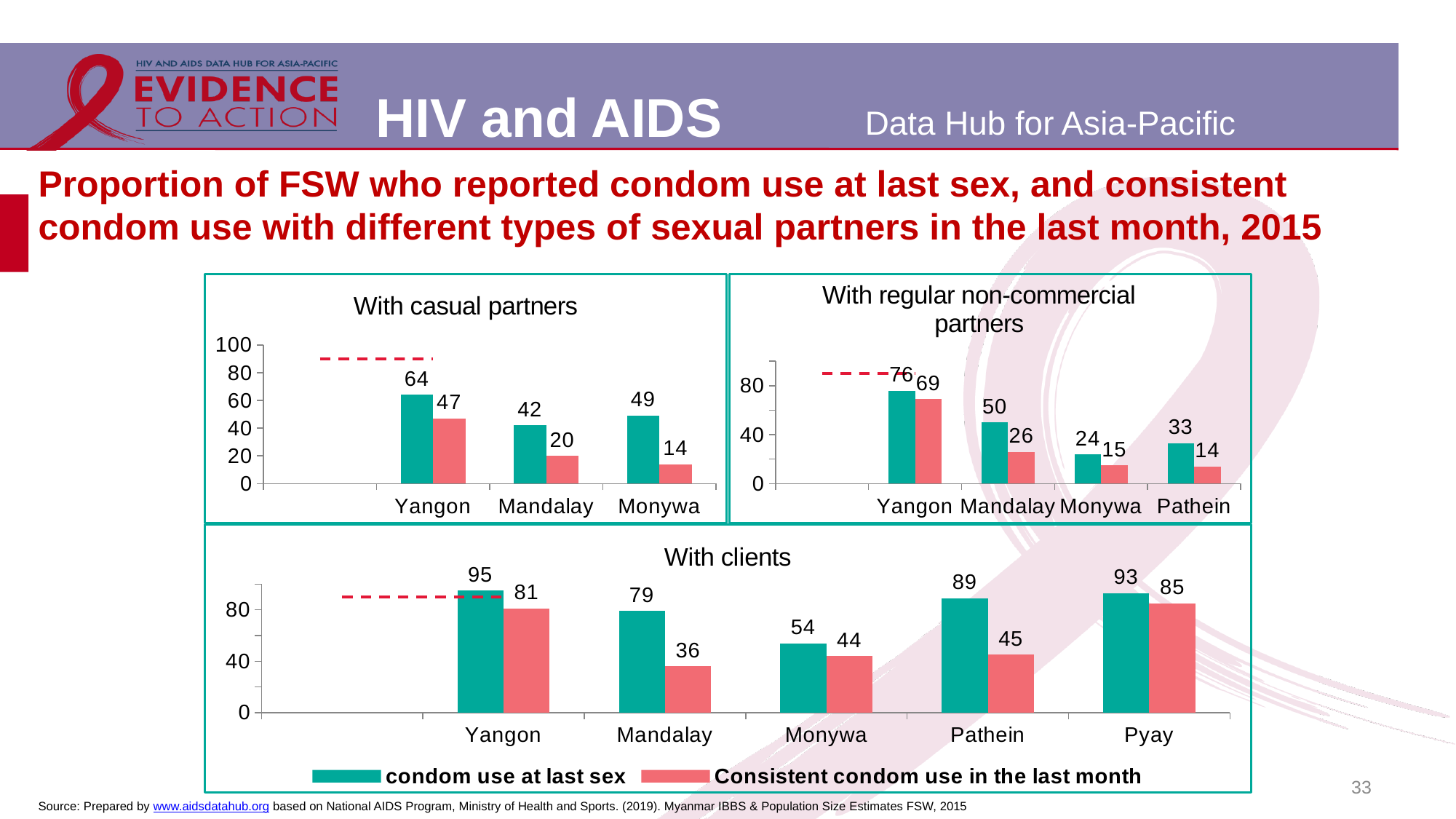
What type of chart is the 'With clients' chart? Bar chart In the 'With regular non-commercial partners' chart, what is the value for consistent condom use in the last month in Pathein? 14 In the 'With clients' chart, what is the difference between condom use at last sex and consistent condom use in the last month in Mandalay? 43 In the 'With clients' chart, what is the value for condom use at last sex in Pathein? 89 How many cities are shown in the 'With clients' chart? 5 In the 'With regular non-commercial partners' chart, which is larger: condom use at last sex in Monywa or in Pathein? Pathein In the 'With casual partners' chart, which city has the lowest value for consistent condom use in the last month? Monywa How many series does the legend list? 2 In the 'With casual partners' chart, what is the value for condom use at last sex in Yangon? 64 How many cities are shown in the 'With casual partners' chart? 3 In the 'With regular non-commercial partners' chart, what is the value for consistent condom use in the last month in Mandalay? 26 In the 'With clients' chart, which city has the highest value for condom use at last sex? Yangon